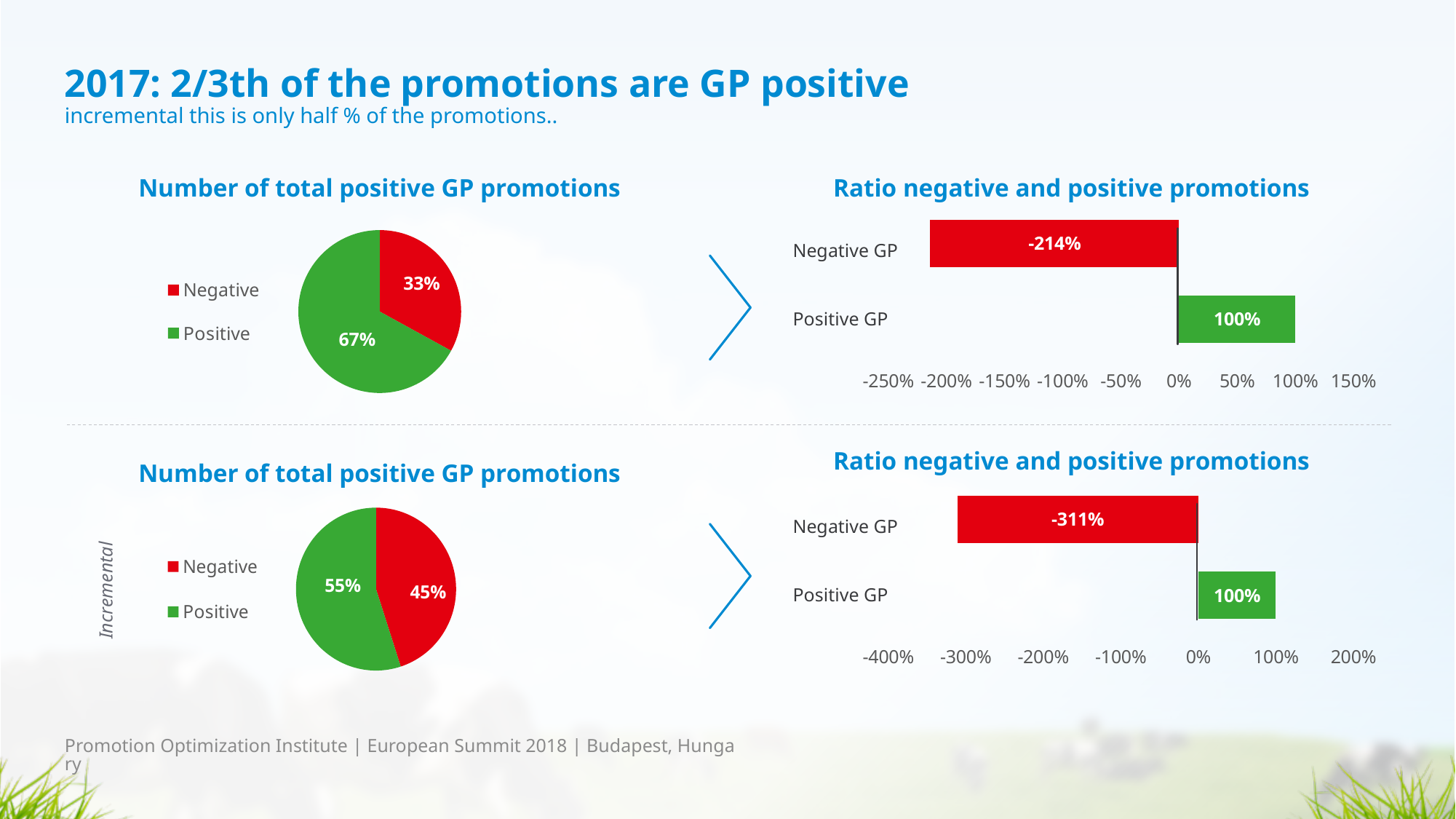
What kind of chart is the top-right chart titled 'Ratio negative and positive promotions'? Bar chart In the bottom-left pie chart (Incremental), which slice is larger, Negative or Positive? Positive In the top-left pie chart, what share of promotions is Negative? 33% How many categories does the bottom-right bar chart show? 2 In the bottom-left pie chart (Incremental), what share of promotions is Negative? 45% In the top-left pie chart, what share of promotions is Positive? 67% In the top-right bar chart, what is the value for Negative GP? -214% In the top-left pie chart, which colour represents Negative? Red In the top-left pie chart, what is the difference between the Positive and Negative shares? 34% What kind of chart is the top-left chart titled 'Number of total positive GP promotions'? Pie chart In the top-right bar chart, what is the value for Positive GP? 100% In the bottom-right bar chart, what is the value for Negative GP? -311%